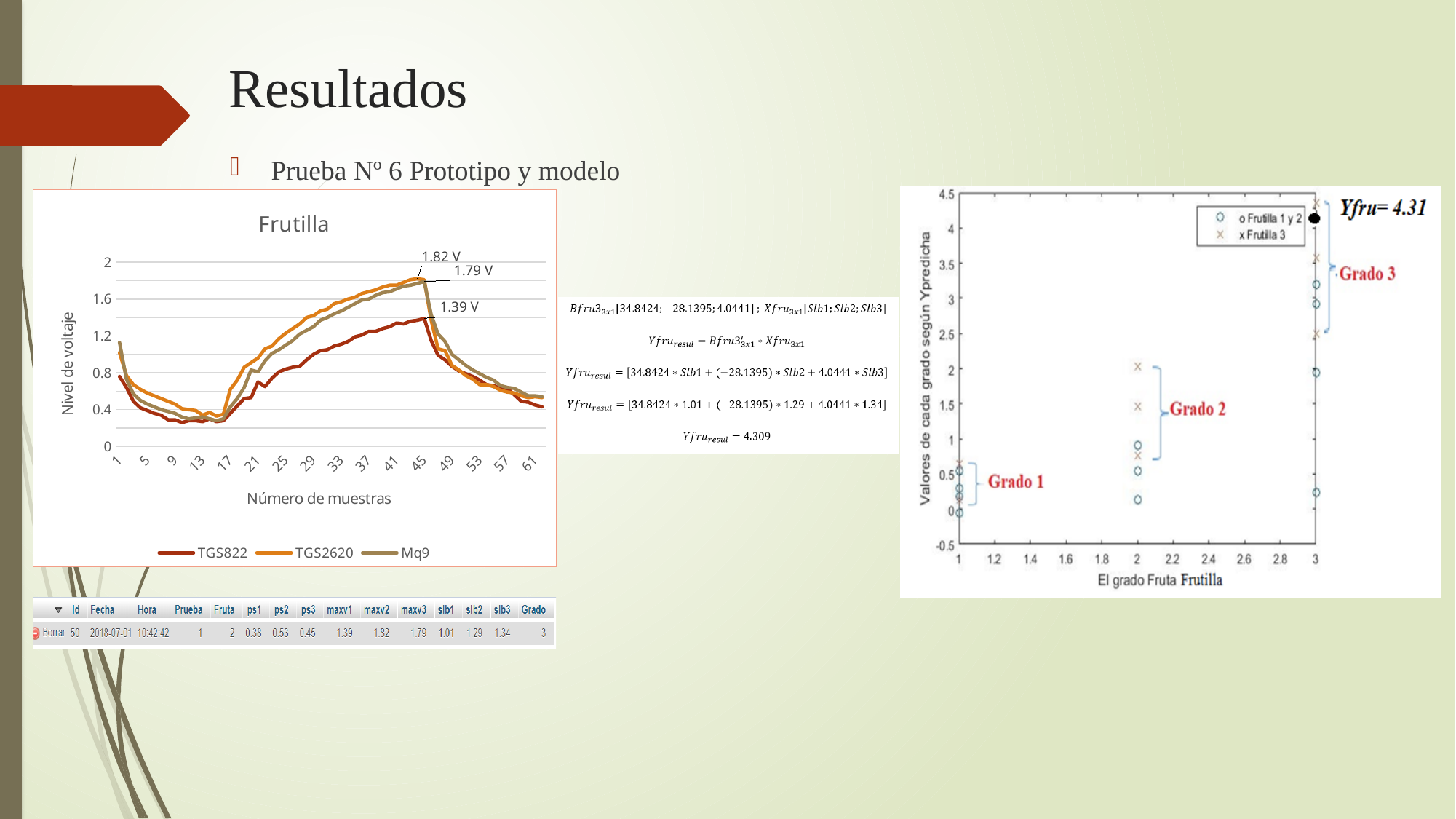
In the 'Frutilla' chart, what is the labelled peak value of the Mq9 series? 1.79 V In the 'Frutilla' chart, which series has the lowest labelled peak? TGS822 In the 'Frutilla' chart, what is the labelled peak value of the TGS822 series? 1.39 V In the 'Frutilla' chart, is the value of TGS822 at sample 13 greater or less than 0.4? less In the 'Frutilla' chart, what is the difference between the labelled peaks of TGS2620 and TGS822? 0.43 V In the 'Frutilla' chart, what kind of chart is shown? line chart In the 'Frutilla' chart, how many series does the legend list? 3 In the 'Frutilla' chart, what is the title of the vertical axis? Nivel de voltaje In the 'Frutilla' chart, which series reaches the highest labelled peak? TGS2620 In the 'Frutilla' chart, is the labelled peak of TGS2620 larger or smaller than that of Mq9? larger In the 'Frutilla' chart, what is the labelled peak value of the TGS2620 series? 1.82 V In the scatter chart on the right, what Yfru value is annotated next to the black point? 4.31